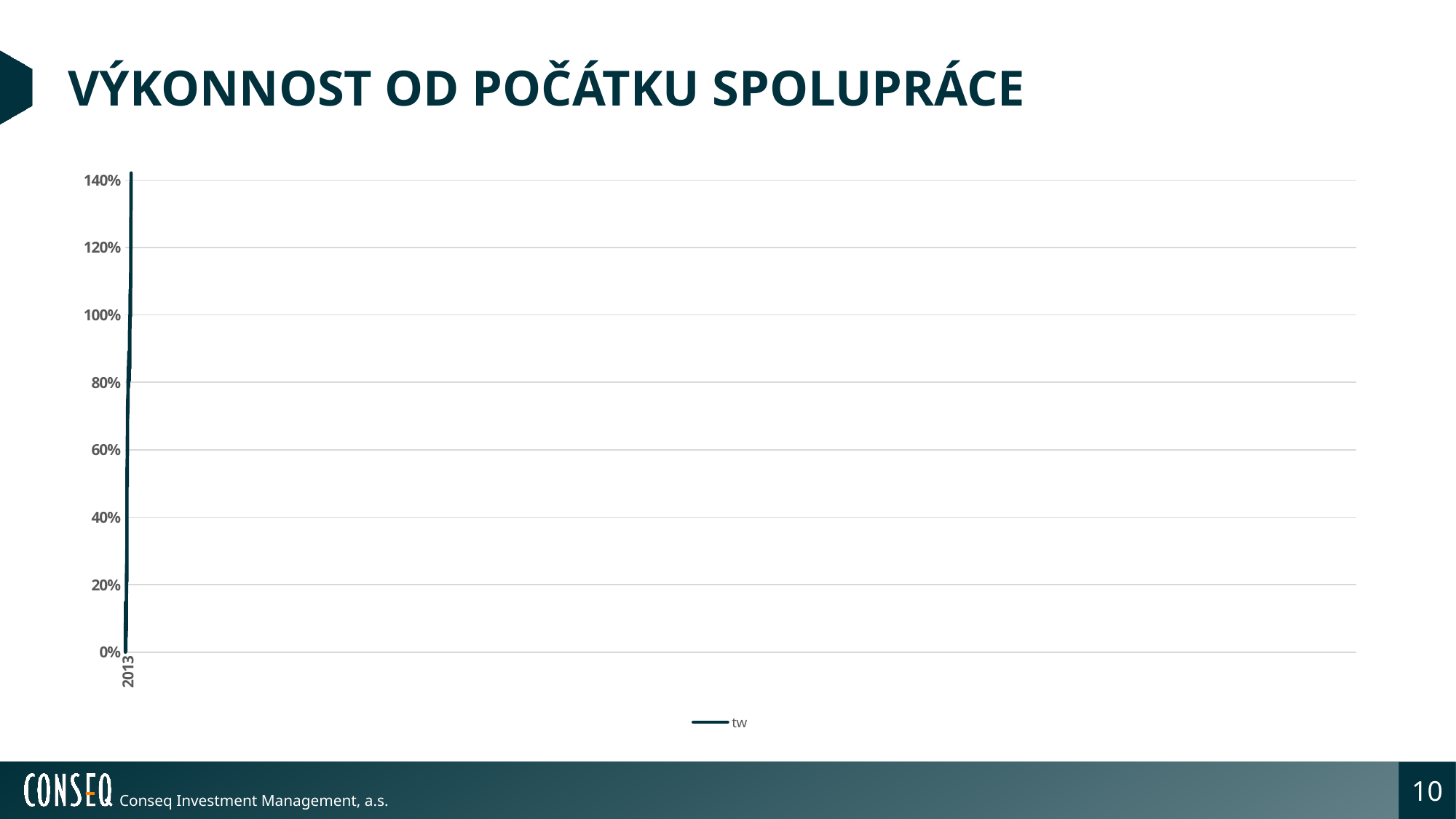
How many year labels are shown on the horizontal axis? 1 What kind of chart is shown on the slide? line chart What is the title of the chart on the slide? VÝKONNOST OD POČÁTKU SPOLUPRÁCE How many series does the legend list? 1 Which year is labelled on the horizontal axis? 2013 What is the name of the series shown in the legend? tw What is the highest value labelled on the vertical axis? 140% What is the lowest value labelled on the vertical axis? 0%